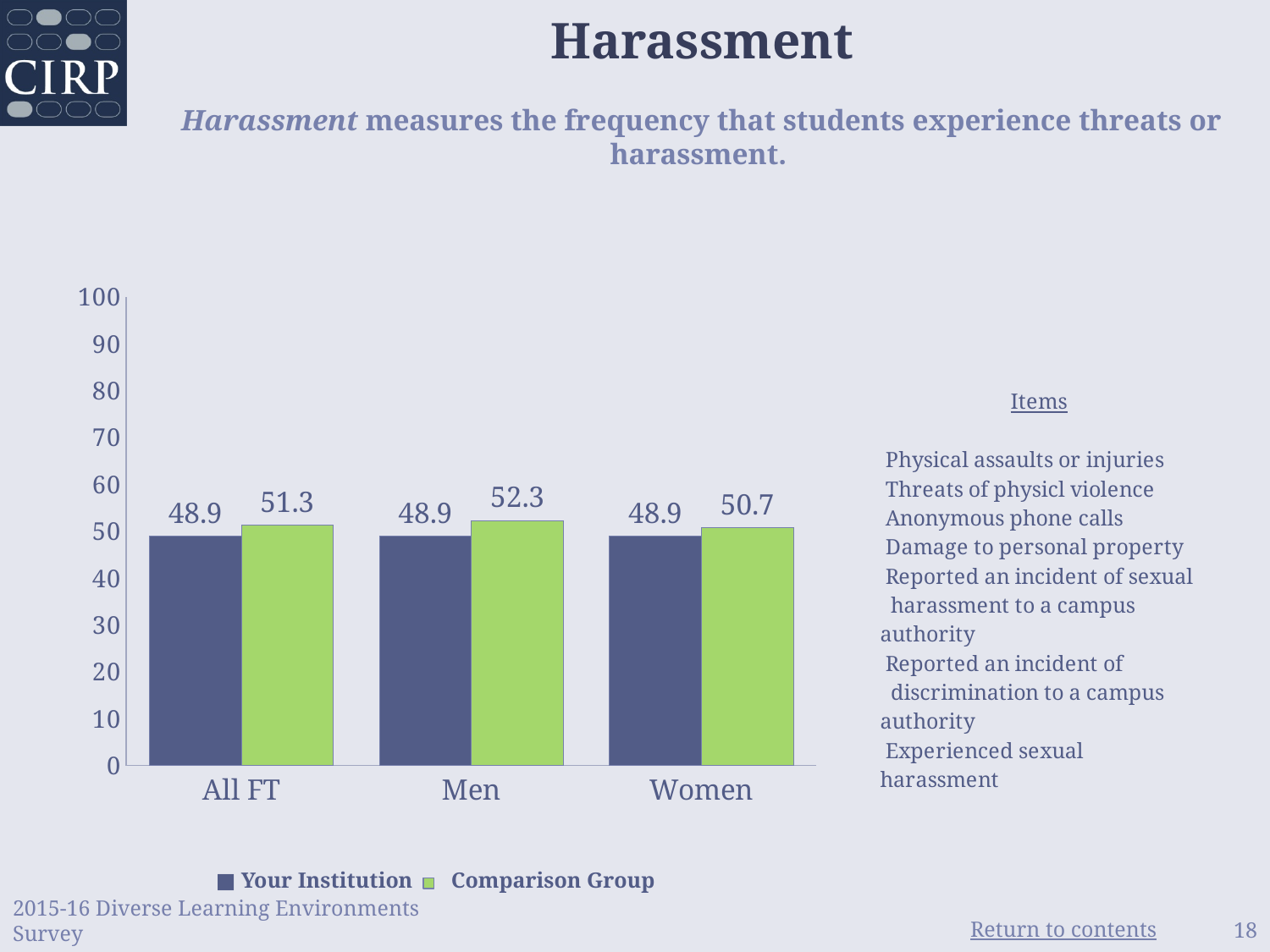
What is the value for the Comparison Group in the All FT category? 51.3 Which category has the highest Comparison Group value? Men How many series does the legend list? 2 What is the difference between the Comparison Group and Your Institution values for Men? 3.4 What is the difference between the Comparison Group values for All FT and Women? 0.6 What kind of chart is shown on the slide? bar chart What is the value for the Comparison Group in the Women category? 50.7 Which category has the lowest Comparison Group value? Women What is the value for Your Institution in the Men category? 48.9 Which is larger for Women: Your Institution or the Comparison Group? Comparison Group Is the value for Your Institution in the All FT category greater or less than 50? less How many categories are shown on the x axis? 3